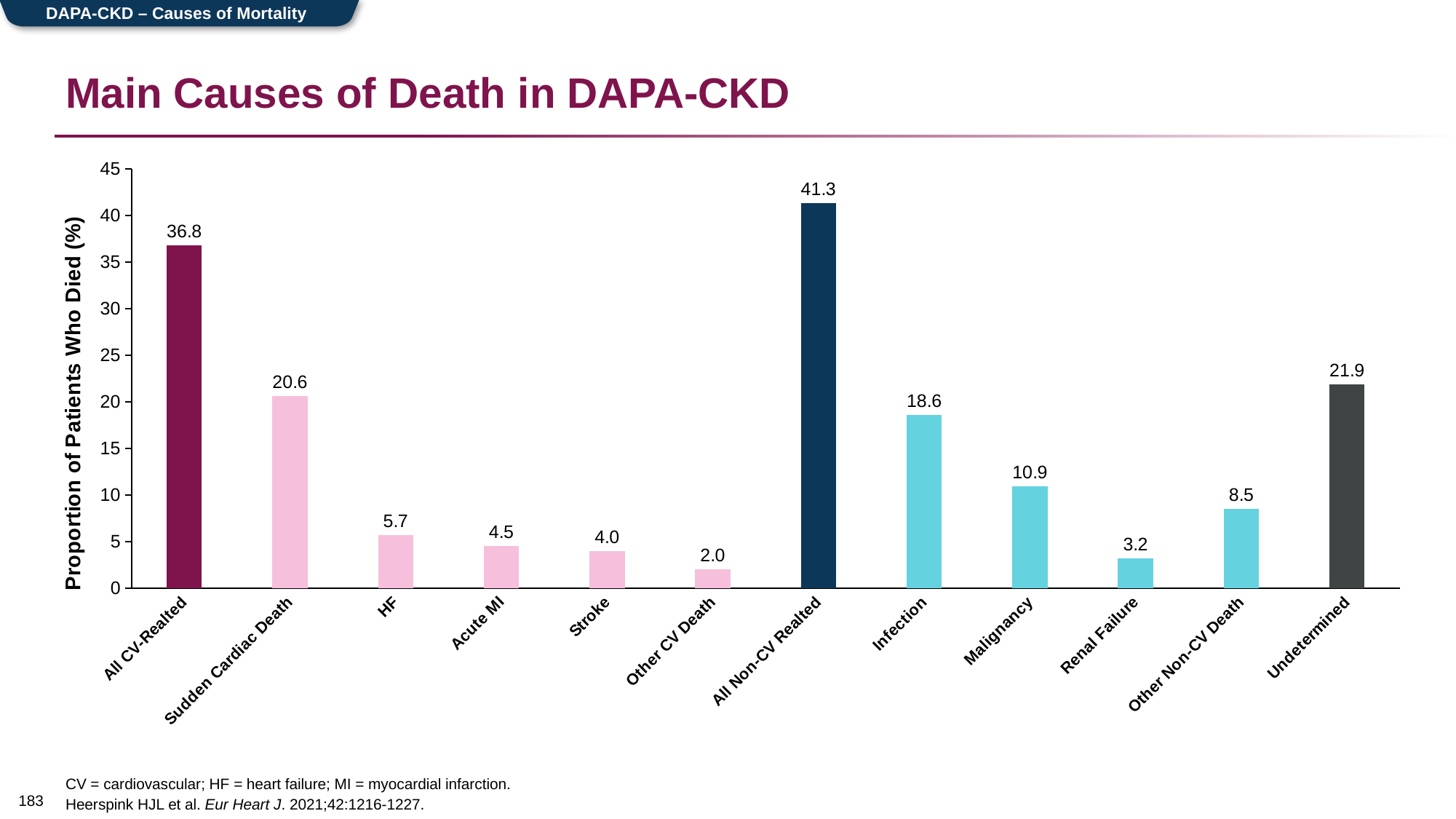
Which is larger, the value for Stroke or the value for Acute MI? Acute MI What is the value for Infection? 18.6 Which category has the lowest value? Other CV Death What is the value for Undetermined? 21.9 What is the difference between the values for All Non-CV Realted and All CV-Realted? 4.5 How many categories are shown on the x axis? 12 What is the label of the y axis? Proportion of Patients Who Died (%) What kind of chart is shown on the slide? bar chart What is the value for Sudden Cardiac Death? 20.6 Which category has the highest value? All Non-CV Realted What is the difference between the values for Malignancy and Other Non-CV Death? 2.4 Is the value for Renal Failure greater or less than 5? less